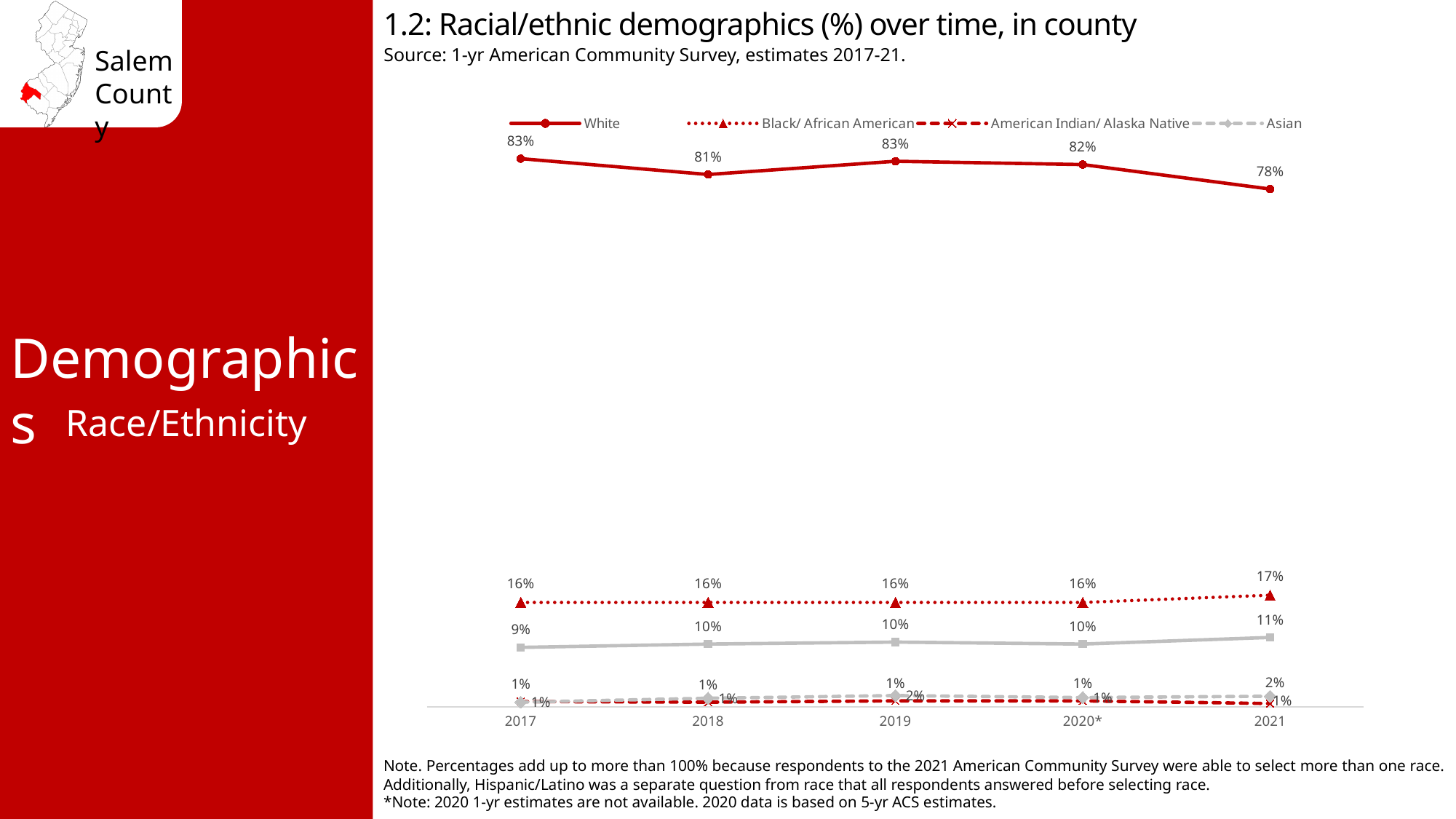
What kind of chart is this? Line chart What is the value for Black/ African American in 2021? 17% Does the White series rise or fall from 2017 to 2021 overall? Fall What is the value for Black/ African American in 2018? 16% What is the value for White in 2017? 83% What is the difference between the White value in 2017 and in 2021? 5 percentage points Which is larger, the White value in 2018 or in 2020*? 2020* What is the value for White in 2021? 78% In which year is the Black/ African American series at its highest? 2021 In which year is the White series at its lowest? 2021 How many years are shown on the x axis? 5 What is the title of the chart? 1.2: Racial/ethnic demographics (%) over time, in county